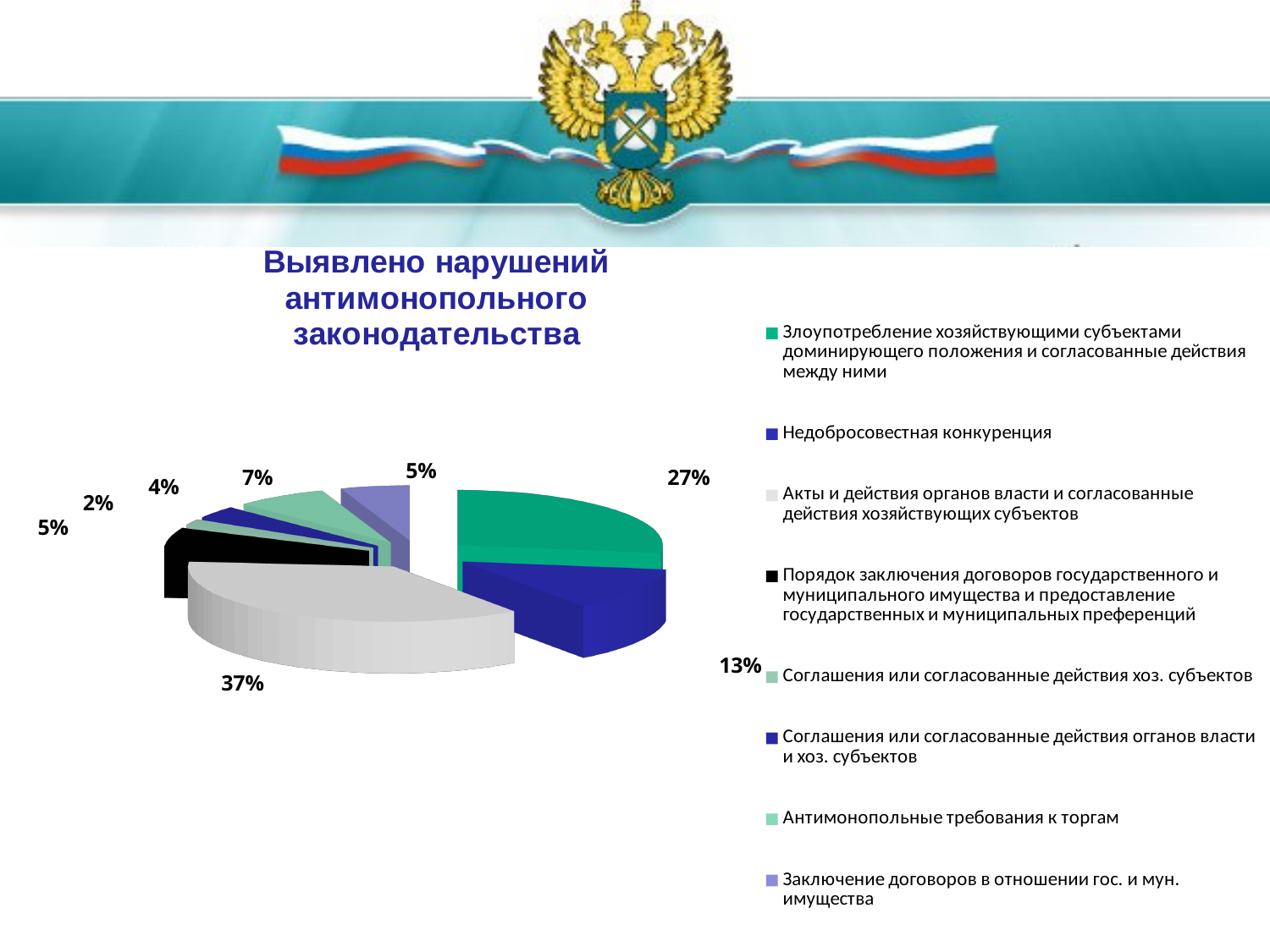
What share is shown for "Антимонопольные требования к торгам"? 7% What is the difference in percentage points between the largest slice (37%) and the slice for "Злоупотребление хозяйствующими субъектами доминирующего положения..." (27%)? 10 percentage points What is the title of the chart? Выявлено нарушений антимонопольного законодательства What colour is the slice for "Порядок заключения договоров государственного и муниципального имущества и предоставление государственных и муниципальных преференций"? Black What kind of chart is shown on the slide? Pie chart What share of the pie is labelled for "Акты и действия органов власти и согласованные действия хозяйствующих субъектов"? 37% Which category has the smallest slice of the pie? Соглашения или согласованные действия хоз. субъектов How many categories does the legend of the pie chart list? 8 What share is shown for "Недобросовестная конкуренция"? 13% What share is shown for "Злоупотребление хозяйствующими субъектами доминирующего положения и согласованные действия между ними"? 27% Which category has the largest slice of the pie? Акты и действия органов власти и согласованные действия хозяйствующих субъектов Which is larger: the share for "Недобросовестная конкуренция" or the share for "Антимонопольные требования к торгам"? Недобросовестная конкуренция